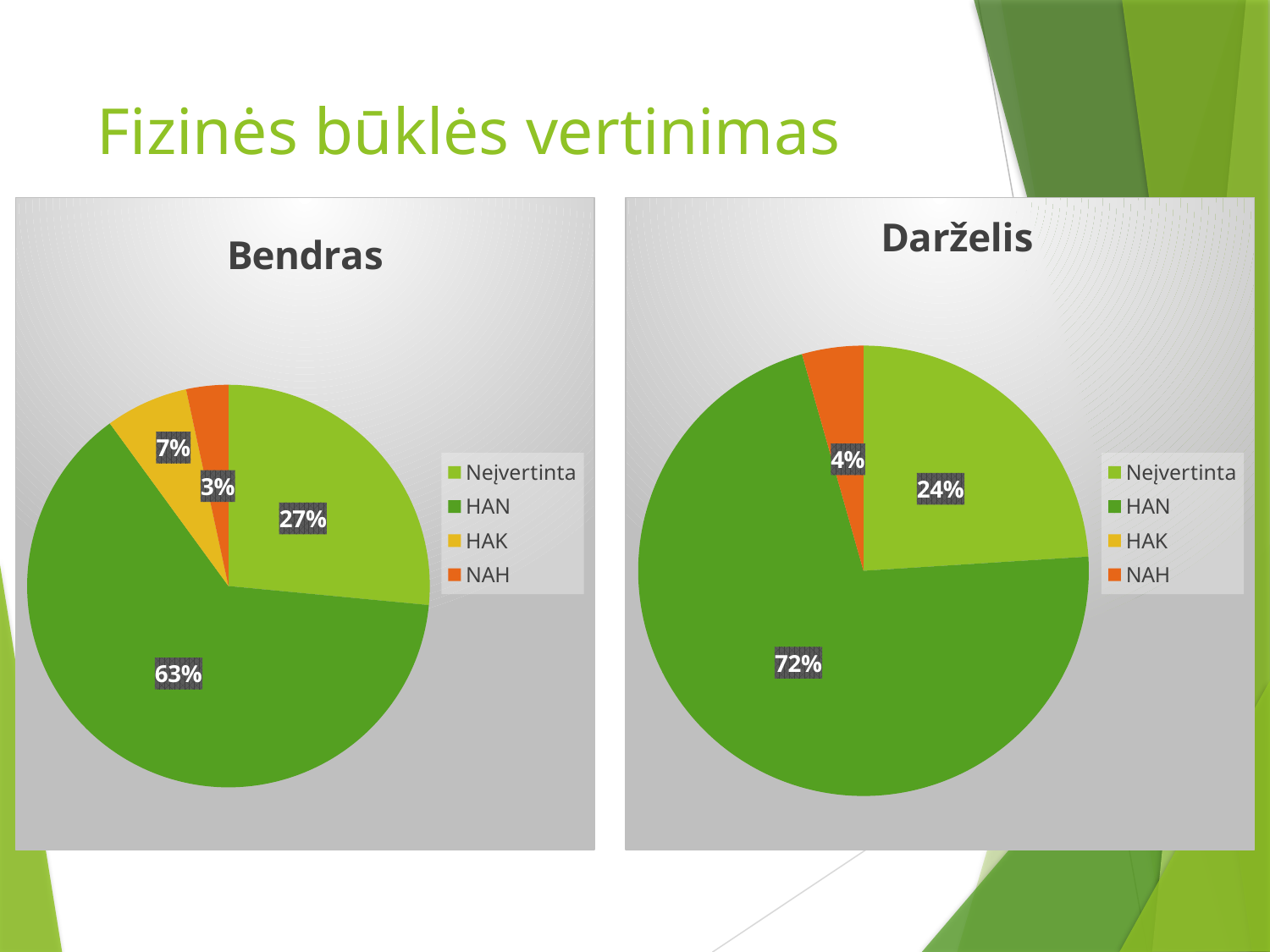
In the "Bendras" chart, what share does HAN have? 63% In the "Bendras" chart, what is the difference between the HAN share and the Neįvertinta share? 36% In the "Darželis" chart, what share does HAN have? 72% In the "Darželis" chart, what share does Neįvertinta have? 24% In the "Bendras" chart, what share does HAK have? 7% In the "Bendras" chart, what share does NAH have? 3% In the "Darželis" chart, what share does NAH have? 4% In the "Bendras" chart, which category has the smallest slice? NAH In the "Bendras" chart, which category has the largest slice? HAN In the "Bendras" chart, what share does Neįvertinta have? 27% Which chart has the larger HAN share, "Bendras" or "Darželis"? Darželis What type of chart is the "Darželis" chart? Pie chart